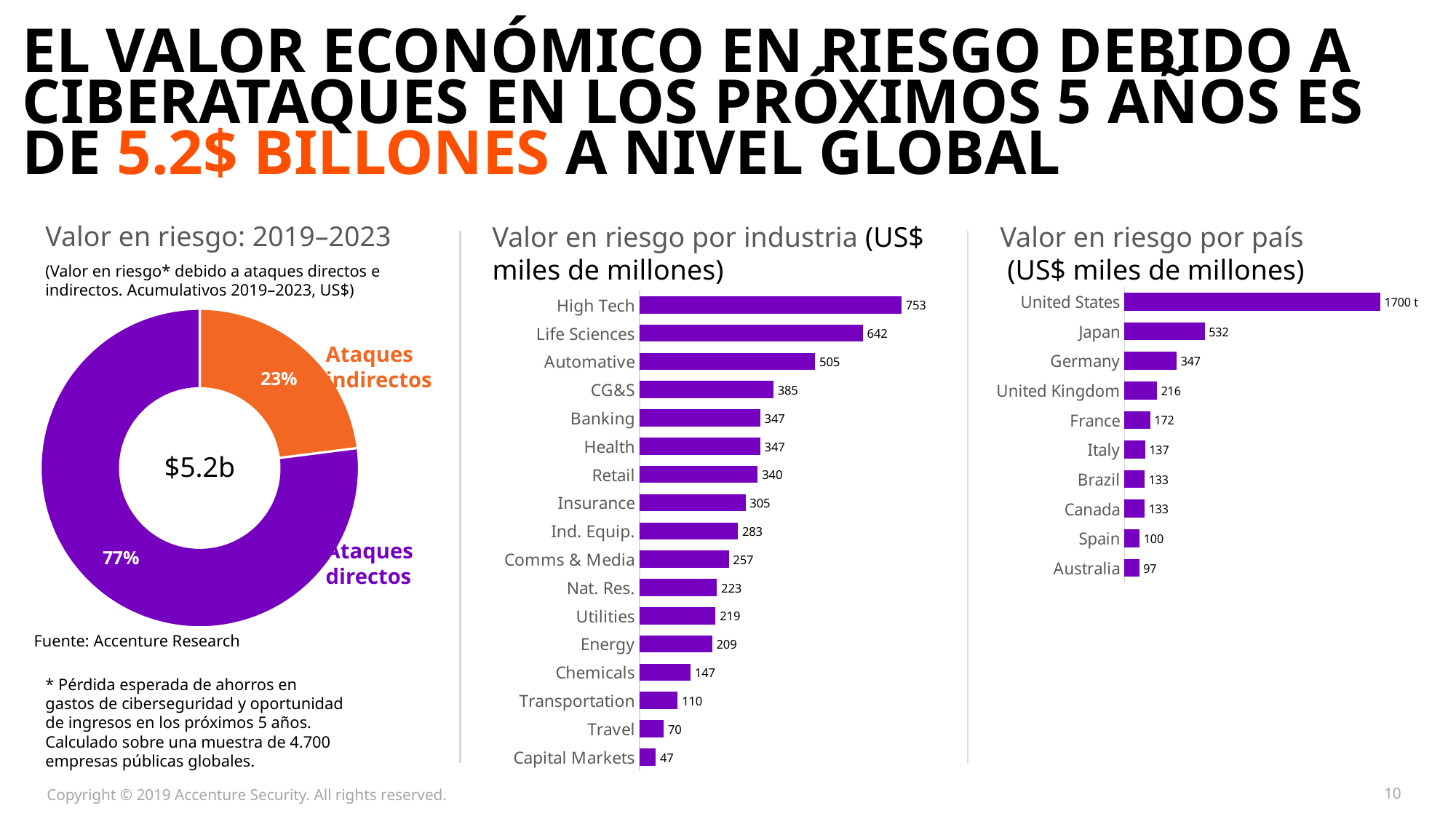
In the 'Valor en riesgo por industria' chart, which industry has the highest value? High Tech In the 'Valor en riesgo por industria' chart, which industry has the lowest value? Capital Markets How many countries are shown in the 'Valor en riesgo por país' chart? 10 In the 'Valor en riesgo por industria' chart, what is the difference between High Tech and Automative? 248 In the 'Valor en riesgo por país' chart, which country has the highest value? United States In the 'Valor en riesgo por país' chart, what is the value for Japan? 532 In the 'Valor en riesgo: 2019–2023' donut chart, what share is attributed to Ataques directos? 77% How many industries are shown in the 'Valor en riesgo por industria' chart? 17 In the 'Valor en riesgo por industria' chart, what is the value for Life Sciences? 642 In the 'Valor en riesgo: 2019–2023' donut chart, what share is attributed to Ataques indirectos? 23% What kind of chart is the 'Valor en riesgo: 2019–2023' chart? Donut (pie) chart In the 'Valor en riesgo por país' chart, which is larger, Germany or United Kingdom? Germany